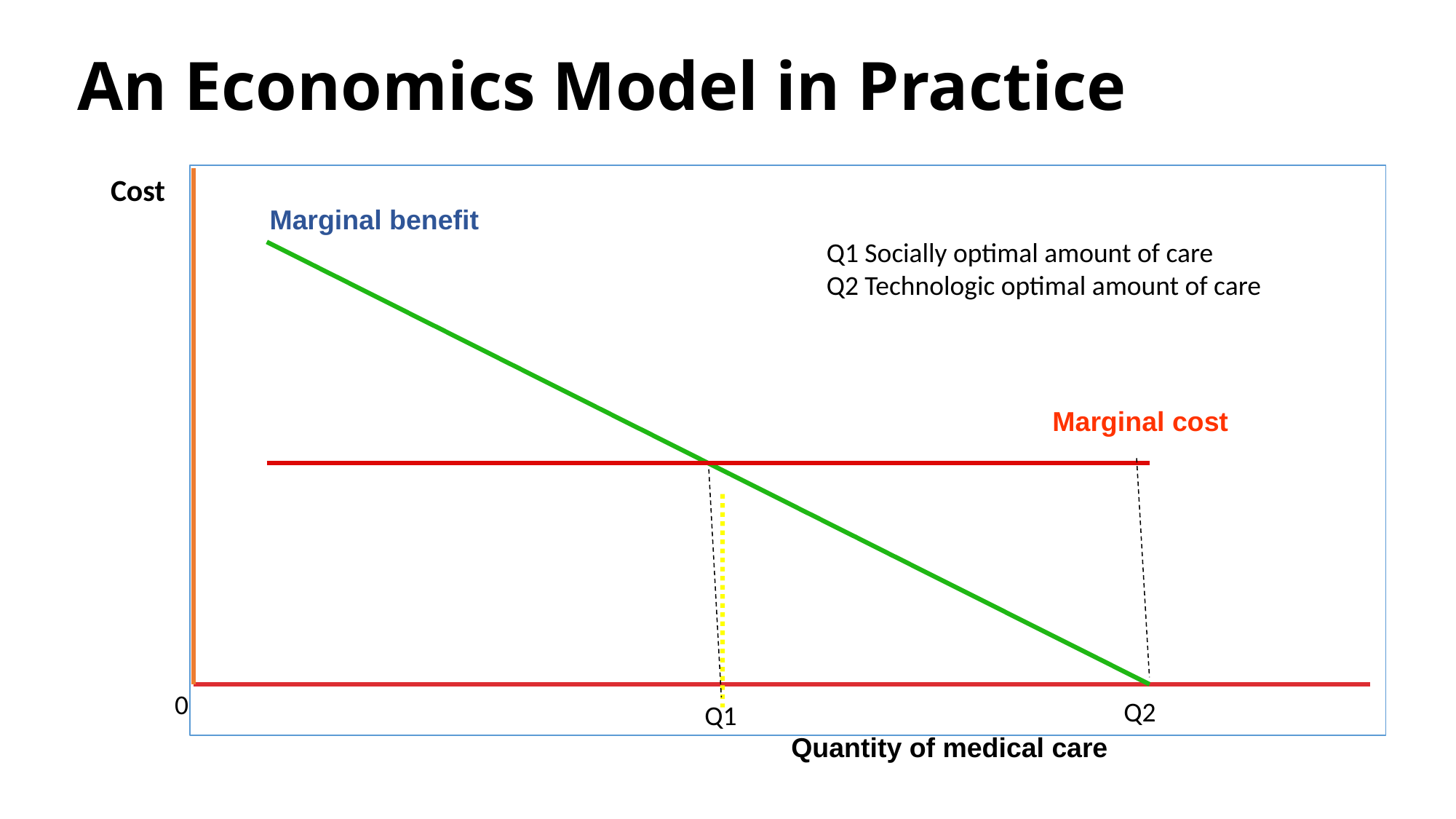
Does the Marginal cost line rise, fall, or stay flat as the quantity of medical care increases? Stay flat How many curves are plotted on the chart? 2 Does the Marginal benefit line rise or fall as the quantity of medical care increases? Fall At which labelled quantity does the Marginal benefit line reach the horizontal axis? Q2 For quantities to the left of Q1, which is larger: Marginal benefit or Marginal cost? Marginal benefit What colour is the Marginal benefit line? Green What does Q1 represent according to the slide? Socially optimal amount of care At which labelled quantity do the Marginal benefit and Marginal cost lines intersect? Q1 What is the label of the horizontal axis? Quantity of medical care What kind of chart is shown on the slide? Line chart How many quantities are labelled on the horizontal axis (excluding 0)? 2 For quantities between Q1 and Q2, which is larger: Marginal benefit or Marginal cost? Marginal cost